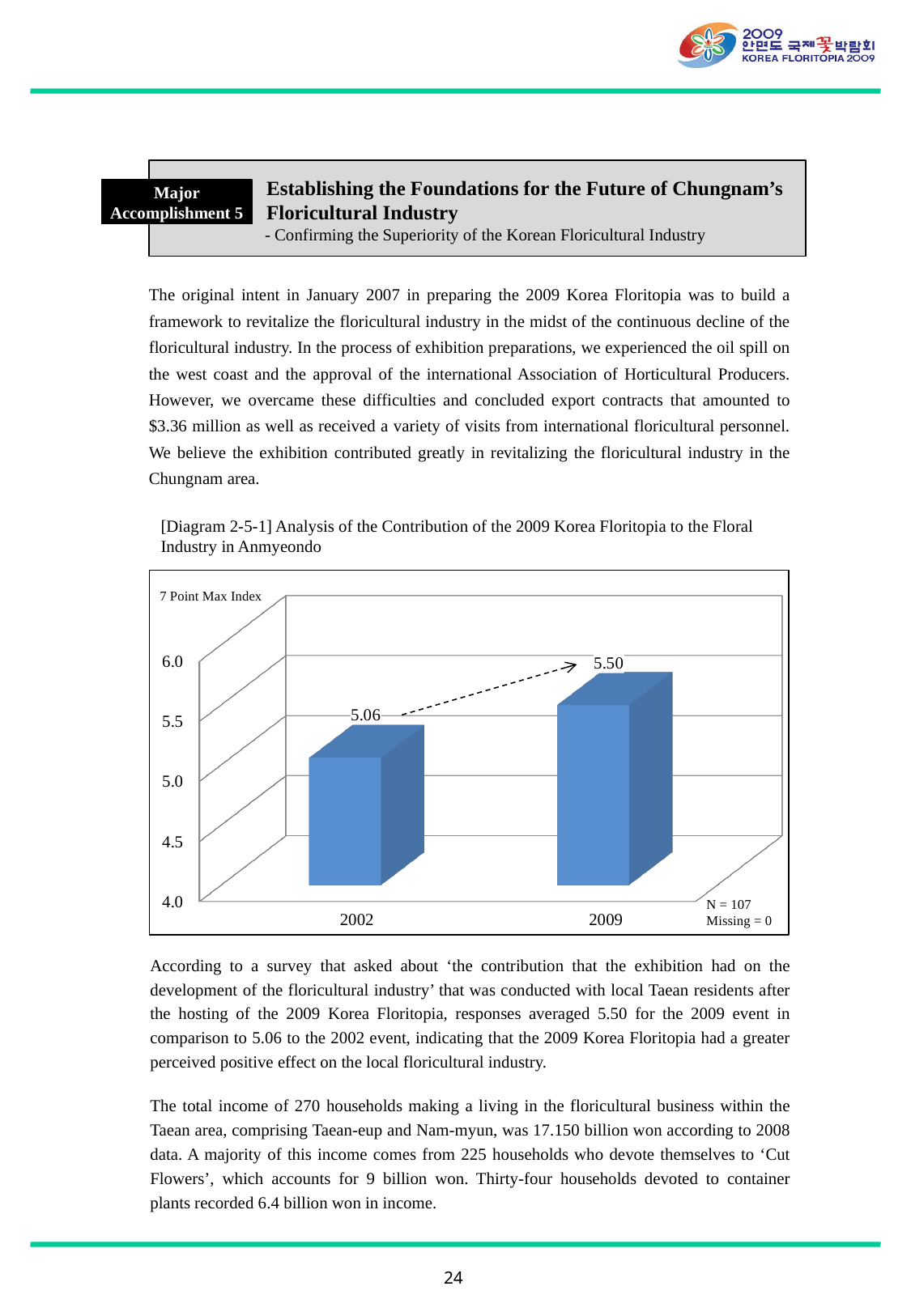
Is the value for 2009 greater or less than 5.0? greater Which year has the lower value in the chart? 2002 Is the value for 2002 larger or smaller than the value for 2009? smaller Which year has the higher value in the chart? 2009 What is the value for 2002 in the chart? 5.06 What is the sample size (N) noted in the chart? 107 What kind of chart is shown on the slide? bar chart What is the maximum index scale noted in the top-left corner of the chart? 7 Point Max Index How many categories are shown on the x axis of the chart? 2 Do the values rise or fall from 2002 to 2009? rise What is the value for 2009 in the chart? 5.50 What is the difference between the 2009 value and the 2002 value? 0.44